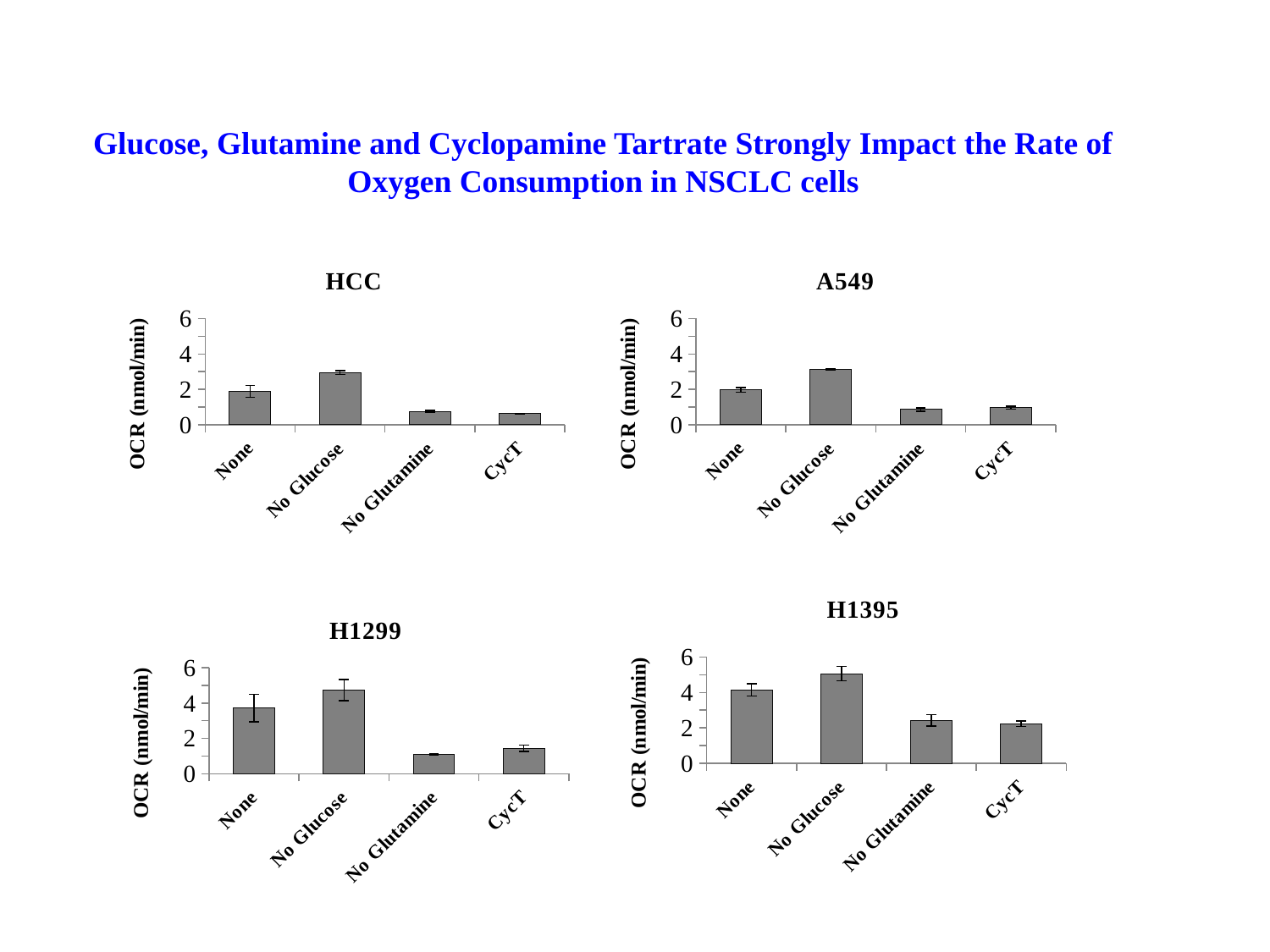
In the A549 chart, which is larger, the value for None or the value for No Glucose? No Glucose In the H1395 chart, which category has the highest OCR? No Glucose In the HCC chart, which category has the highest OCR? No Glucose In the H1299 chart, is the value for No Glucose greater or less than 4? greater In the HCC chart, is the value for No Glutamine greater or less than 2? less How many categories are shown on the x axis of the H1299 chart? 4 What kind of chart is the A549 chart? Bar chart In the H1395 chart, is the value for No Glucose greater or less than 4? greater In the A549 chart, which category has the highest OCR? No Glucose What is the y-axis label of the HCC chart? OCR (nmol/min)